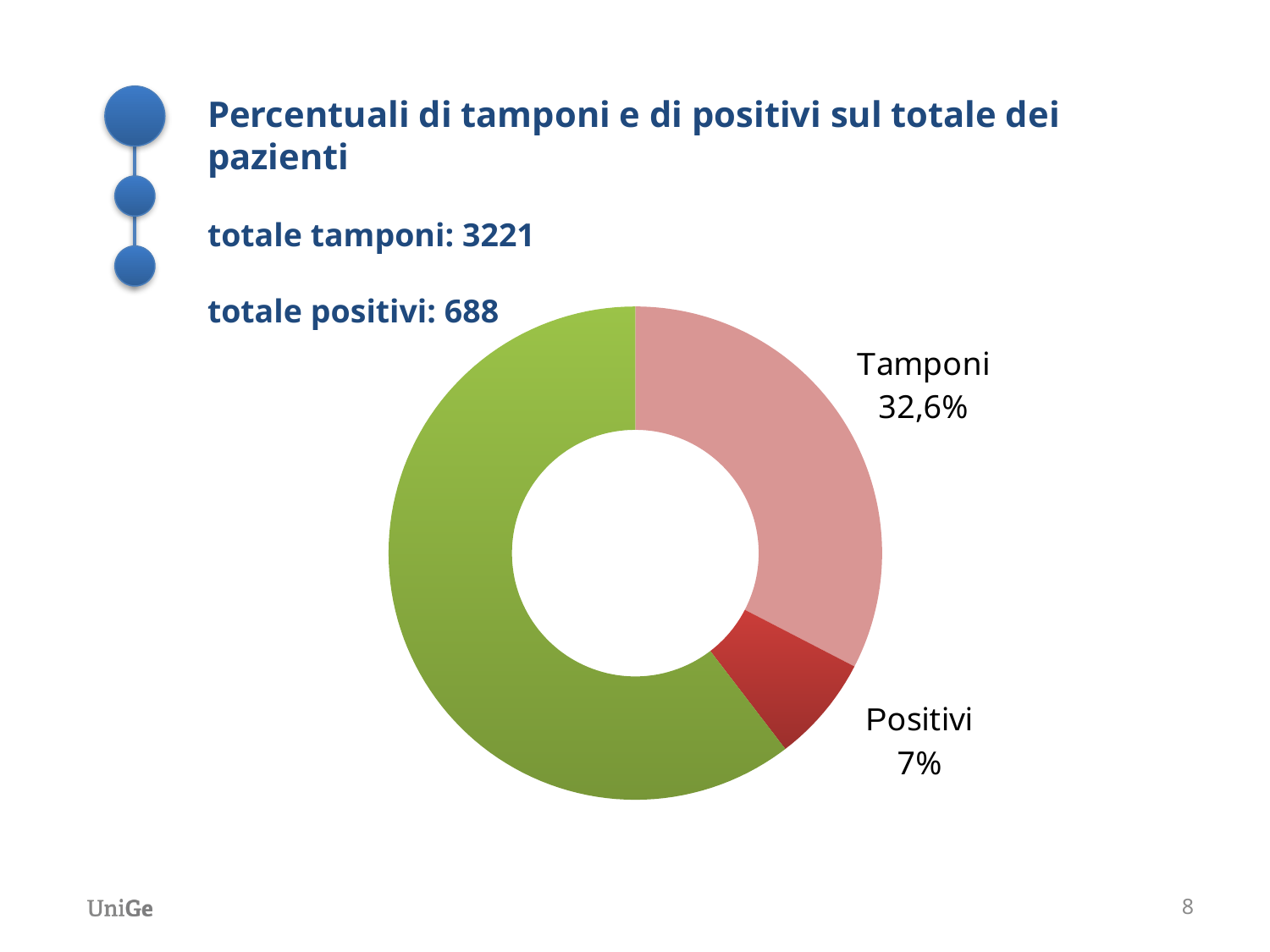
Is the value for Positivi greater or less than 10%? less What colour is the Positivi slice? Red What percentage is shown for the Tamponi slice? 32,6% What percentage is shown for the Positivi slice? 7% How many slices of the chart are labelled with a percentage? 2 How many slices does the doughnut chart have in total? 3 What kind of chart is shown on the slide? Doughnut (pie) chart What is the title of the chart on the slide? Percentuali di tamponi e di positivi sul totale dei pazienti Is the value for Tamponi greater or less than 30%? greater What is the difference in percentage points between the Tamponi slice and the Positivi slice? 25,6 What is the combined percentage of the two labelled slices, Tamponi and Positivi? 39,6% Which labelled slice is larger, Tamponi or Positivi? Tamponi